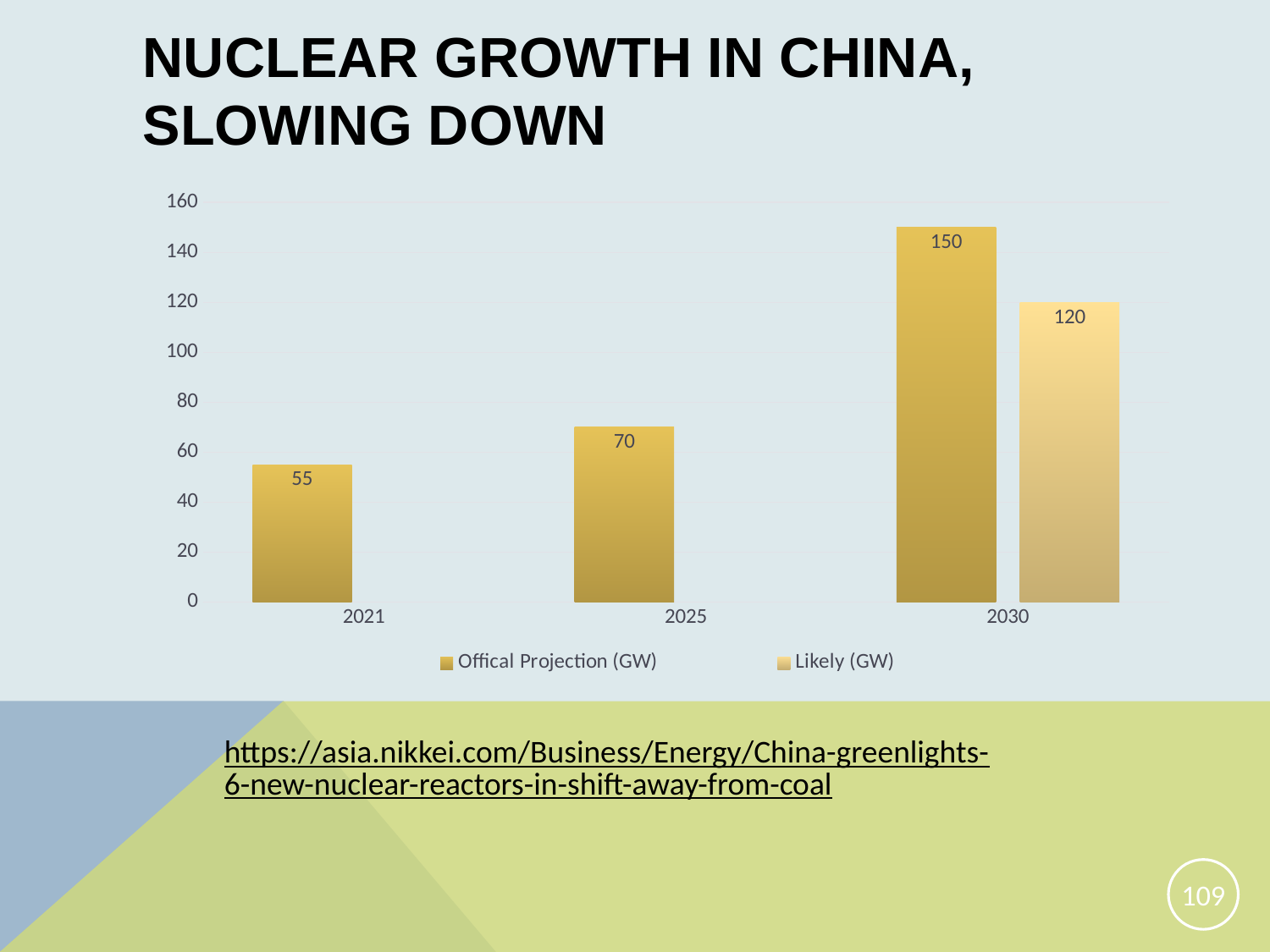
What is the Offical Projection (GW) value for 2021? 55 What is the difference between the Offical Projection (GW) values for 2025 and 2021? 15 Which year has the lowest Offical Projection (GW) value? 2021 What is the Offical Projection (GW) value for 2030? 150 What kind of chart is shown on the slide? Bar chart Which is larger for 2030, the Offical Projection (GW) or the Likely (GW) value? Offical Projection (GW) What is the difference between the Offical Projection (GW) and Likely (GW) values for 2030? 30 What is the Likely (GW) value for 2030? 120 Which year has the highest Offical Projection (GW) value? 2030 How many years are shown on the x axis? 3 How many series does the legend list? 2 What is the Offical Projection (GW) value for 2025? 70